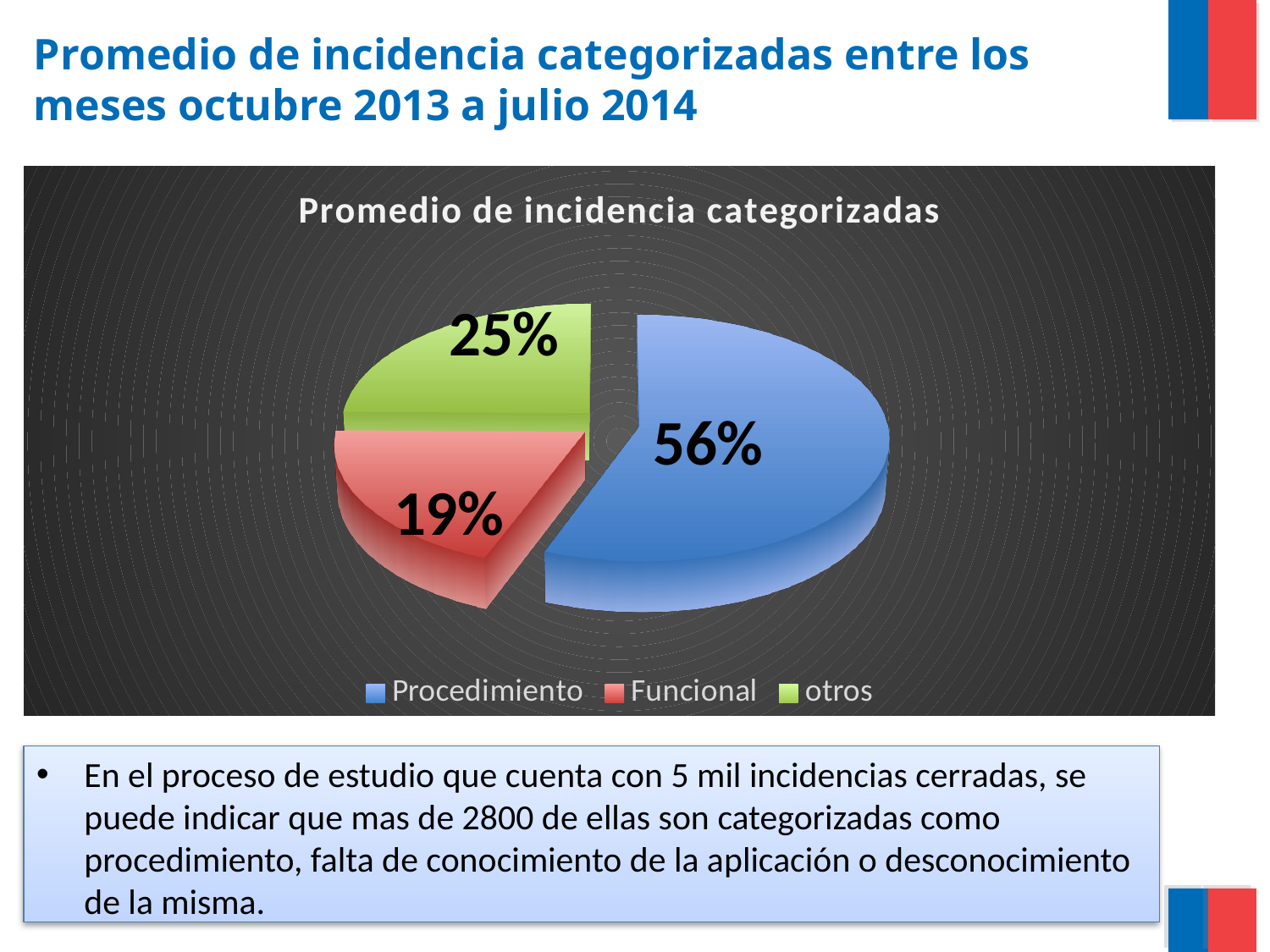
What share of the pie does Funcional represent? 19% Which category has the largest slice of the pie? Procedimiento Which category has the smallest slice of the pie? Funcional What share of the pie does Procedimiento represent? 56% What colour is the slice for Funcional? Red What is the difference in percentage points between Procedimiento and otros? 31 Which is larger, the share for otros or the share for Funcional? otros How many categories are shown in the pie chart? 3 What is the difference in percentage points between otros and Funcional? 6 What share of the pie does otros represent? 25% What is the title of the chart? Promedio de incidencia categorizadas What kind of chart is shown on the slide? Pie chart